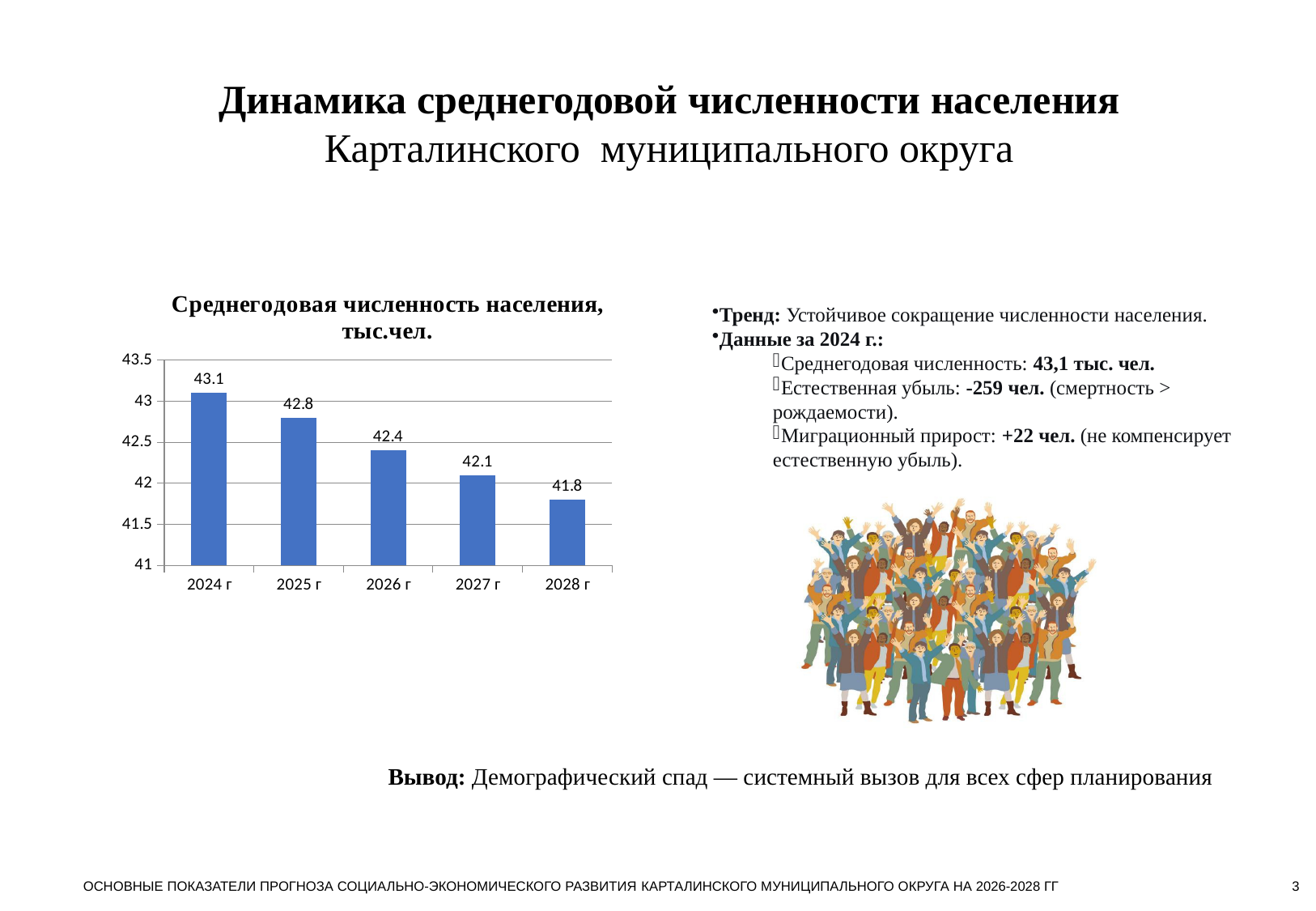
Do the values rise or fall from 2024 г to 2028 г? fall What is the difference between the values for 2025 г and 2027 г? 0.7 Is the value for 2027 г greater or less than 42.5? less What is the value for 2024 г? 43.1 What is the value for 2028 г? 41.8 What is the difference between the values for 2024 г and 2028 г? 1.3 What is the value for 2026 г? 42.4 How many years are shown on the x axis? 5 What kind of chart is shown? bar chart Which is larger, the value for 2025 г or the value for 2027 г? 2025 г Which year has the lowest value? 2028 г Which year has the highest value? 2024 г